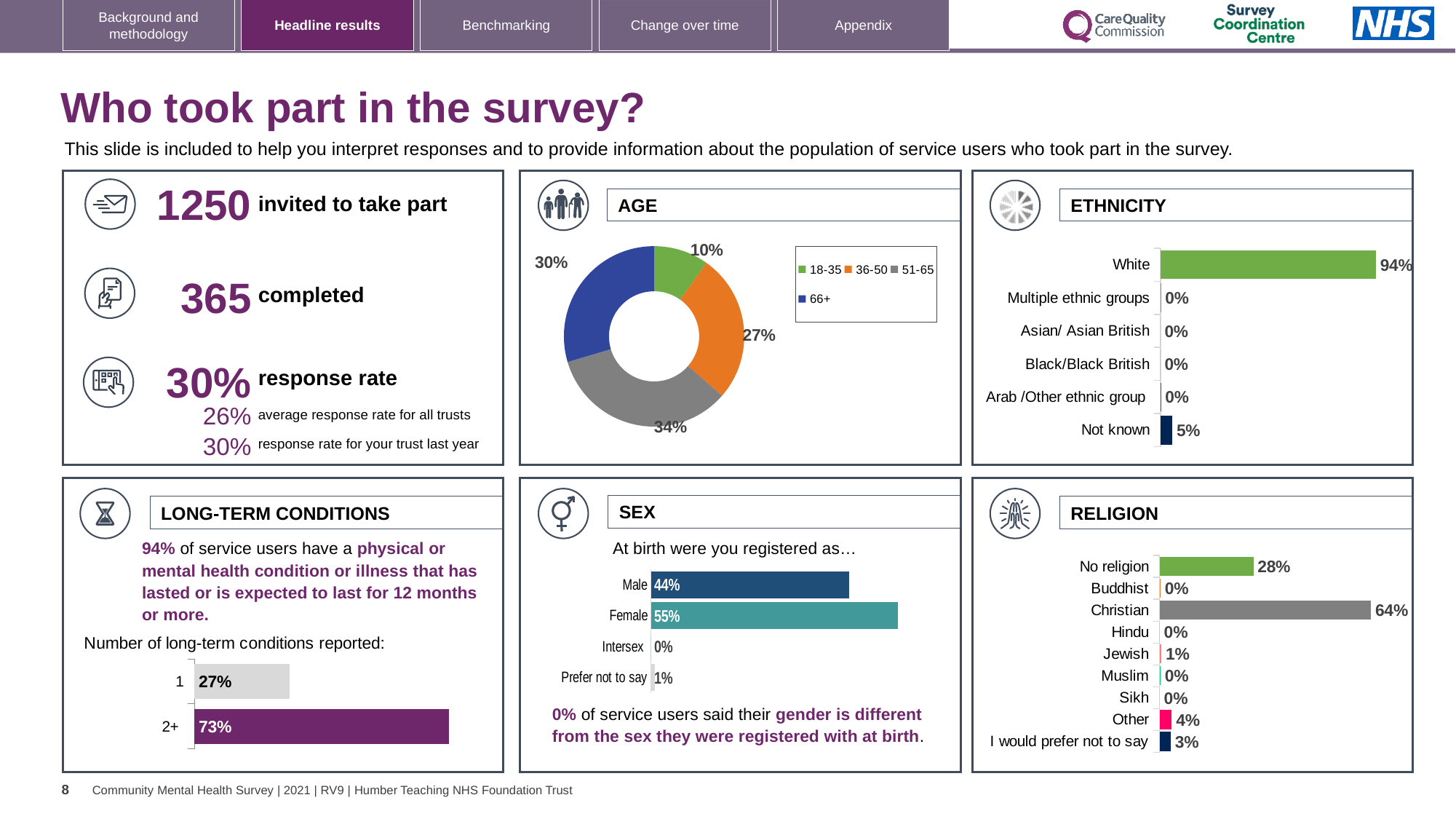
In the AGE chart, which age group has the smallest share? 18-35 In the AGE chart, what share of respondents are aged 51-65? 34% In the SEX chart, what is the value for Prefer not to say? 1% How many age groups does the legend of the AGE chart list? 4 In the ETHNICITY chart, what is the value for Not known? 5% In the SEX chart, which is larger, Male or Female? Female In the LONG-TERM CONDITIONS chart, what is the difference between the share reporting 2+ conditions and the share reporting 1 condition? 46% In the RELIGION chart, which category has the highest value? Christian In the ETHNICITY chart, how many ethnicity categories are shown? 6 What kind of chart is the AGE chart? Donut (pie) chart In the RELIGION chart, what is the difference between Christian and No religion? 36% In the ETHNICITY chart, what is the value for White? 94%